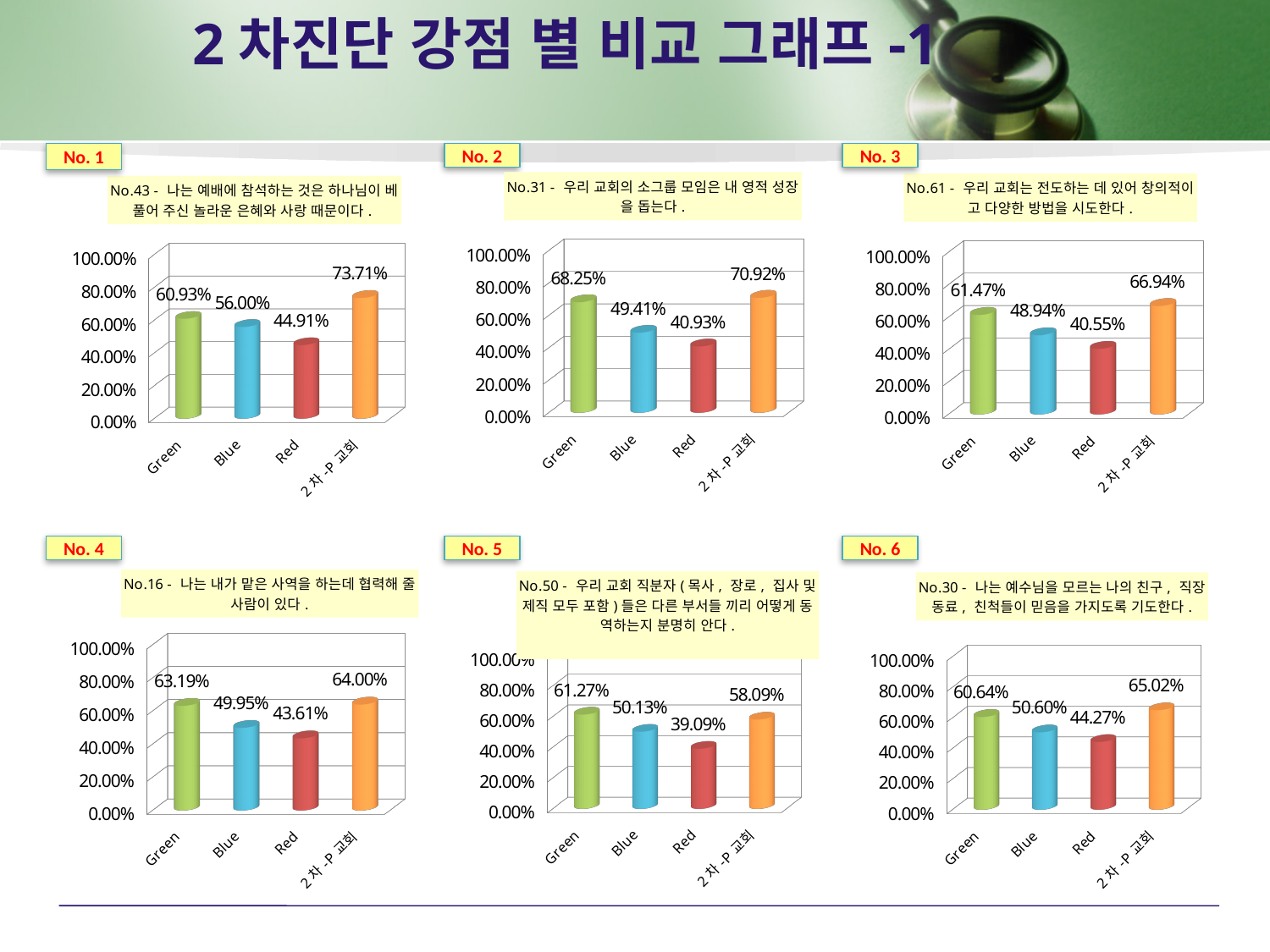
In the No. 3 chart, what is the value for Blue? 48.94% In the No. 6 chart, what is the difference between the values for Blue and Red? 6.33% In the No. 3 chart, which category has the lowest value? Red In the No. 2 chart, what is the difference between the values for 2 차 -P 교회 and Green? 2.67% In the No. 5 chart, is the value for Red greater or less than 40.00%? less In the No. 2 chart, what is the value for Red? 40.93% How many categories are shown on the x axis of the No. 6 chart? 4 In the No. 1 chart, what is the value for Green? 60.93% In the No. 5 chart, what is the value for 2 차 -P 교회? 58.09% What kind of chart is the No. 4 chart? Bar chart In the No. 1 chart, which category has the highest value? 2 차 -P 교회 In the No. 4 chart, which is larger, the value for Green or the value for 2 차 -P 교회? 2 차 -P 교회